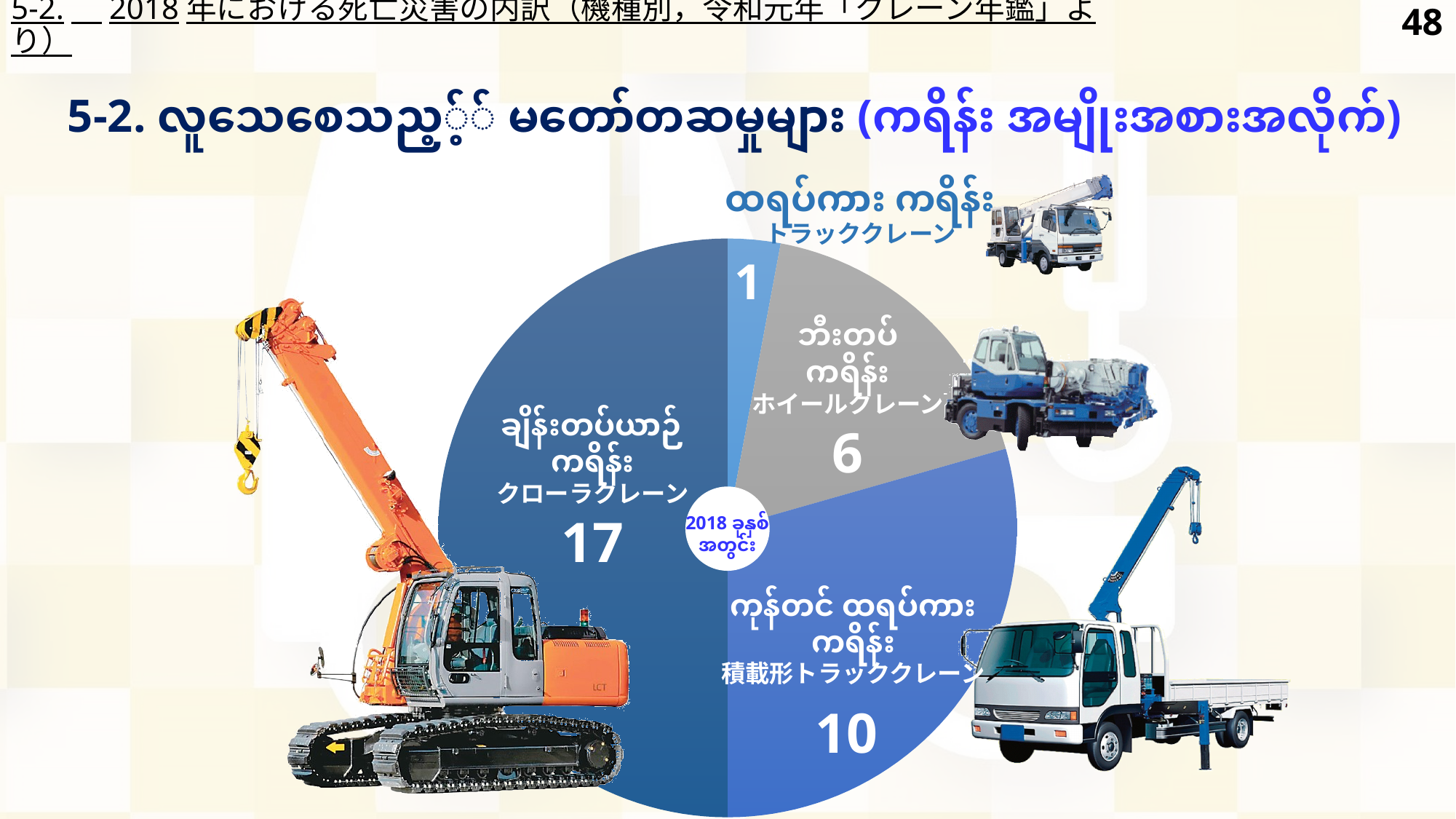
Which crane type has the smallest slice in the pie chart? truck crane (トラッククレーン) Which crane type has the largest slice in the pie chart? crawler crane (クローラクレーン) What is the total of all four slices in the pie chart? 34 How many slices does the pie chart have? 4 What kind of chart is shown on the slide? pie chart What is the value shown for the crawler crane (クローラクレーン) slice? 17 Which is larger, the wheel crane value or the loading-type truck crane value? loading-type truck crane What year is written in the centre of the pie chart? 2018 What is the difference between the crawler crane value and the loading-type truck crane value? 7 What is the value shown for the truck crane (トラッククレーン) slice? 1 What is the value shown for the loading-type truck crane (積載形トラッククレーン) slice? 10 What is the value shown for the wheel crane (ホイールクレーン) slice? 6